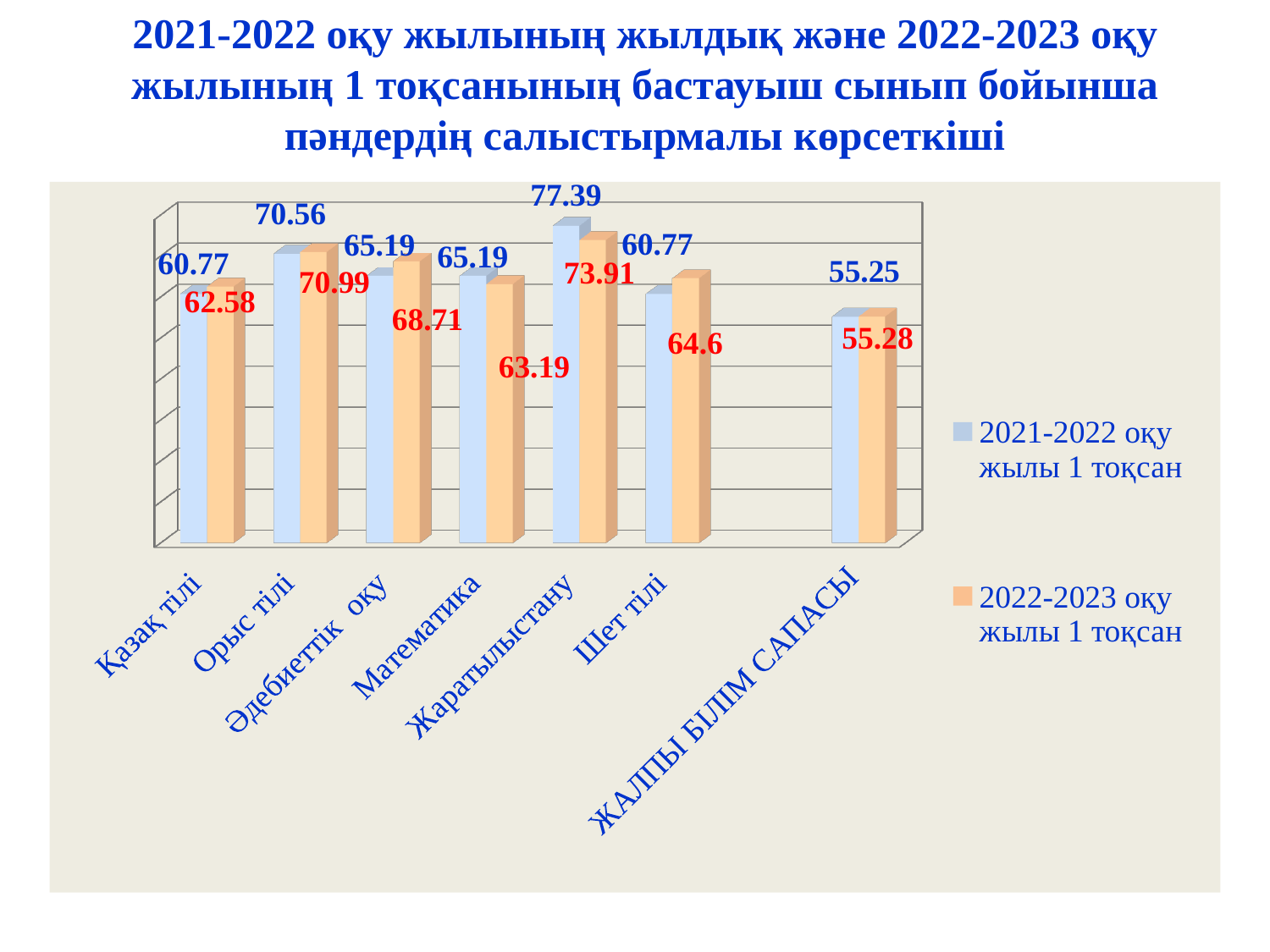
What is the value for Математика in the 2021-2022 оқу жылы 1 тоқсан series? 65.19 What is the difference between the 2022-2023 and 2021-2022 values for Әдебиеттік оқу? 3.52 What is the value for Шет тілі in the 2022-2023 оқу жылы 1 тоқсан series? 64.6 Which category has the lowest value in the 2022-2023 оқу жылы 1 тоқсан series? ЖАЛПЫ БІЛІМ САПАСЫ Which colour represents the 2022-2023 оқу жылы 1 тоқсан series? Orange How many categories are shown on the x axis? 7 What is the value for ЖАЛПЫ БІЛІМ САПАСЫ in the 2022-2023 оқу жылы 1 тоқсан series? 55.28 Which category has the highest value in the 2021-2022 оқу жылы 1 тоқсан series? Жаратылыстану What is the difference between the 2021-2022 and 2022-2023 values for Жаратылыстану? 3.48 For Математика, which series has the larger value: 2021-2022 оқу жылы 1 тоқсан or 2022-2023 оқу жылы 1 тоқсан? 2021-2022 оқу жылы 1 тоқсан What kind of chart is shown on the slide? Bar chart How many series does the legend list? 2